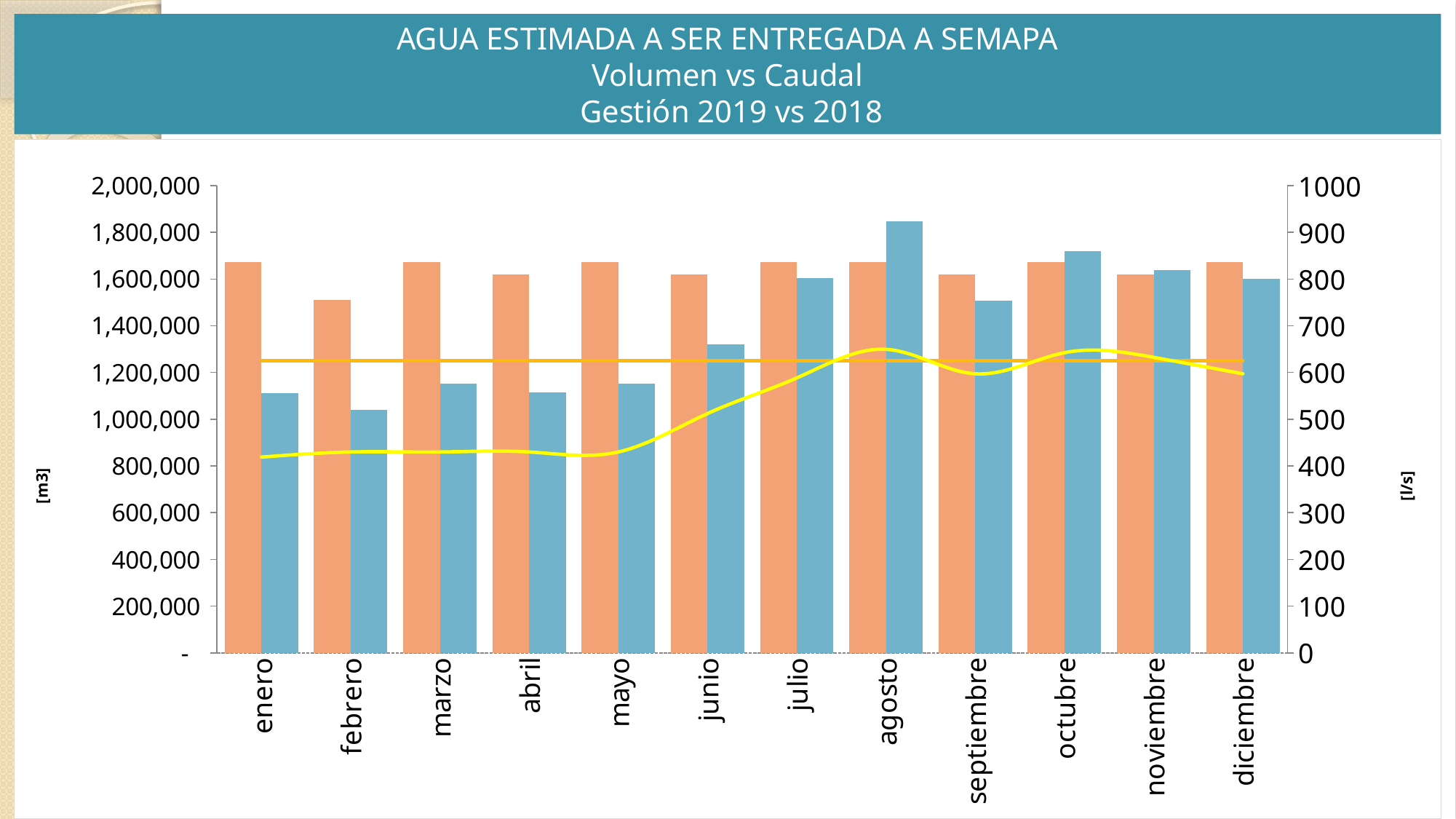
What unit is shown on the right-hand vertical axis? [l/s] How many months are shown on the x axis? 12 In which month is the blue bar the highest? agosto In which month is the orange bar the lowest? febrero In which month is the blue bar the lowest? febrero Is the orange bar for febrero greater or less than 1,600,000? less What is the title of the chart? AGUA ESTIMADA A SER ENTREGADA A SEMAPA Volumen vs Caudal Gestión 2019 vs 2018 Does the yellow line rise or fall from mayo to agosto? rise Which is larger, the blue bar for agosto or the blue bar for octubre? agosto Is the blue bar for febrero greater or less than 1,200,000? less What kind of chart is shown on the slide? Combination bar and line chart Is the blue bar for agosto greater or less than 1,800,000? greater